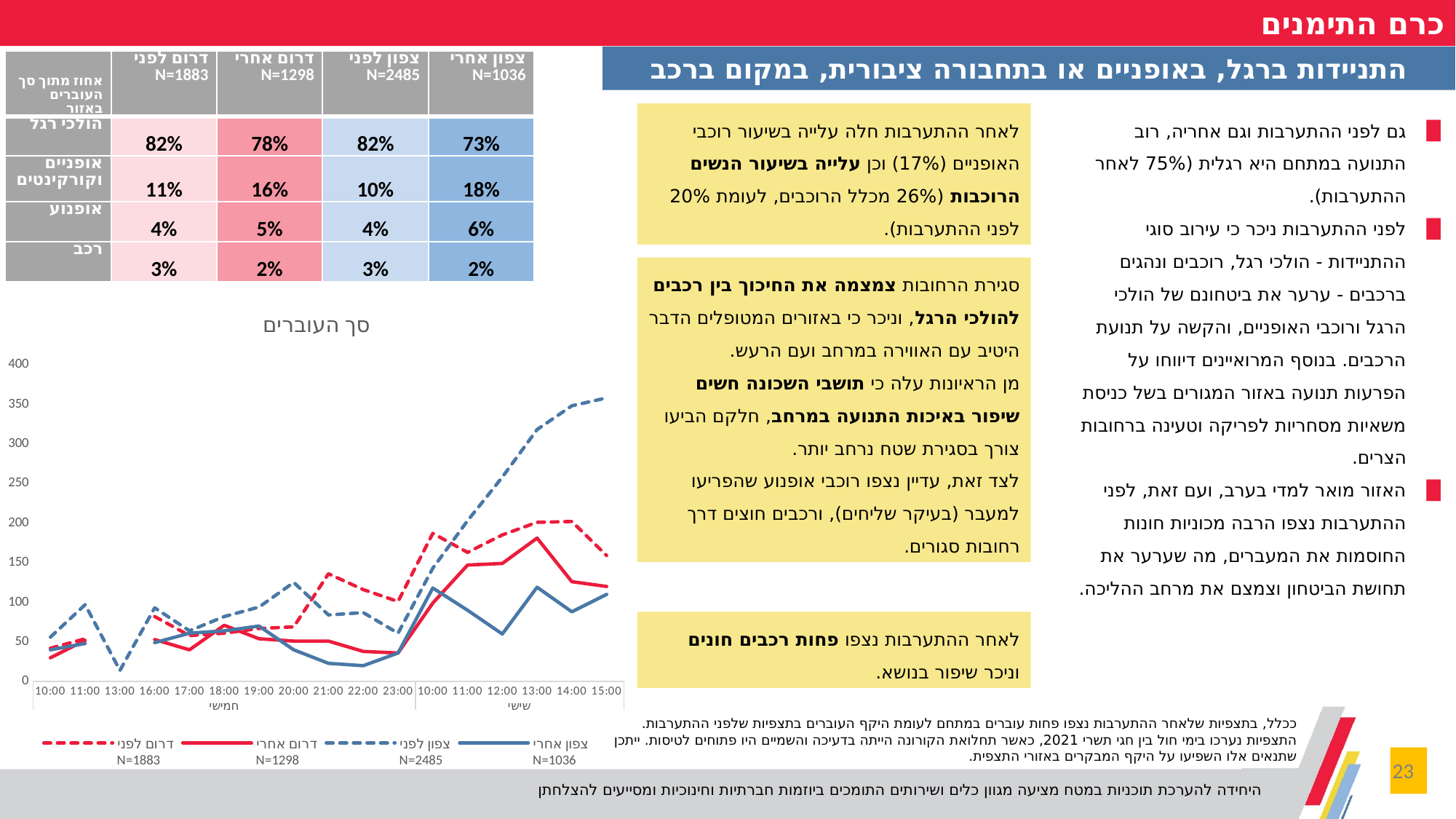
In the סך העוברים chart, does the צפון לפני series rise or fall from 10:00 to 15:00 on שישי? rise What is the highest tick value shown on the y axis of the סך העוברים chart? 400 In the סך העוברים chart, which series reaches the highest value anywhere on the chart? צפון לפני In the סך העוברים chart, at 15:00 on שישי, which is larger: צפון לפני or דרום אחרי? צפון לפני In the סך העוברים chart, is the value for דרום לפני at 21:00 on חמישי greater or less than 100? greater In the סך העוברים chart, is the value for צפון לפני at 15:00 on שישי greater or less than 300? greater In the סך העוברים chart, is the value for צפון לפני at 13:00 on חמישי greater or less than 50? less How many series does the legend of the סך העוברים chart list? 4 What is the title of the line chart on the slide? סך העוברים How many time points are plotted along the x axis of the סך העוברים chart? 17 What kind of chart is the chart titled סך העוברים? line chart